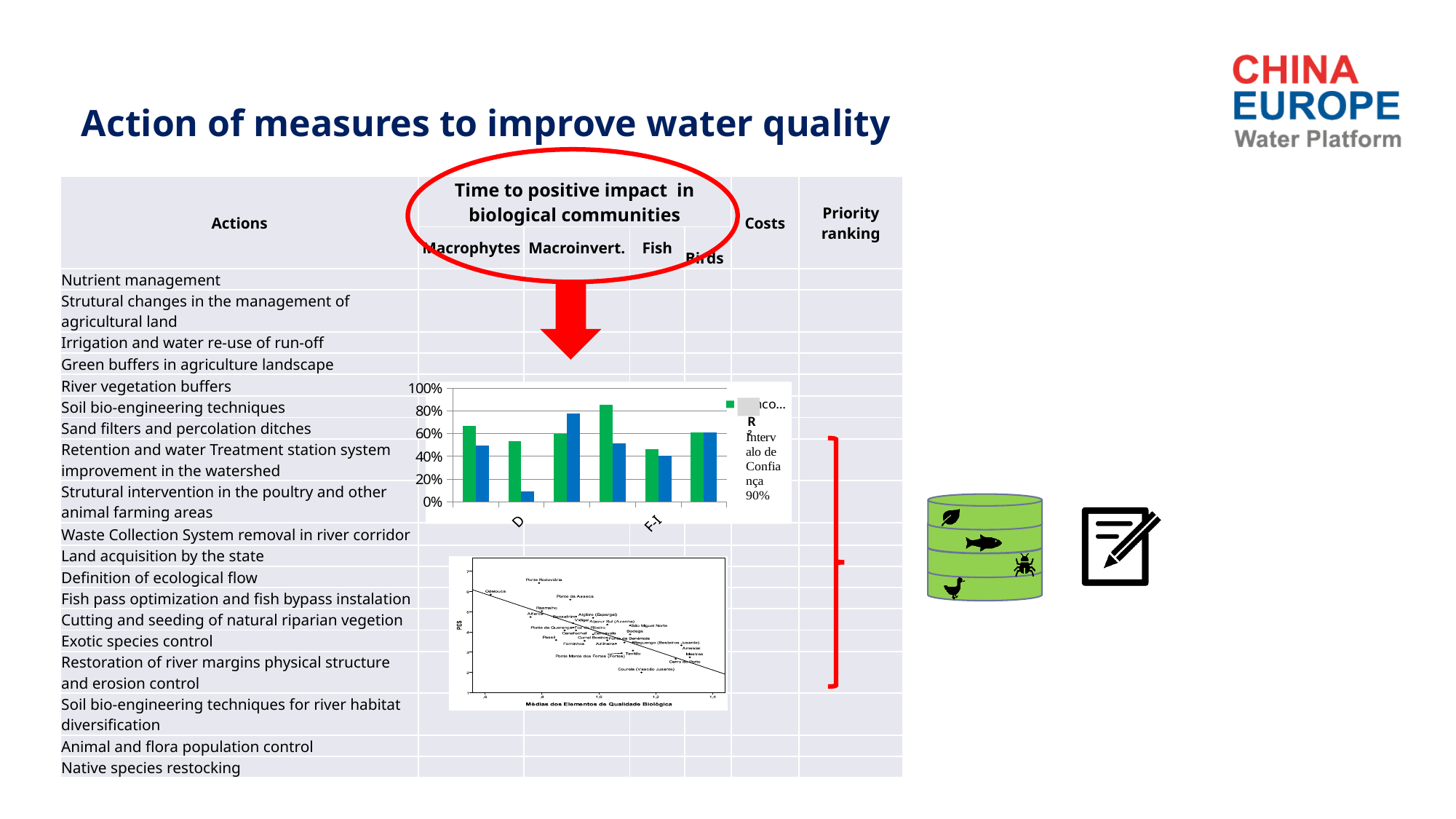
In the bar chart with the percentage axis, how many series of bars (colours) are plotted? 2 In the bar chart with the percentage axis, how many groups of bars are plotted? 6 In the bar chart with the percentage axis, is the green bar for D greater or less than 40%? greater In the bar chart with the percentage axis, which is larger for D, the green bar or the blue bar? green bar What kind of chart is the chart with the percentage axis on the slide? bar chart In the bar chart with the percentage axis, is the blue bar for D greater or less than 20%? less In the bar chart with the percentage axis, which labelled category has the lowest blue bar? D In the bar chart with the percentage axis, is the blue bar for F-I greater or less than 20%? greater In the bar chart with the percentage axis, what is the highest value shown on the vertical axis? 100% What kind of chart is the lower chart with the axis title 'Médias dos Elementos de Qualidade Biológica'? scatter chart In the lower scatter chart, does the fitted line rise or fall from left to right? fall